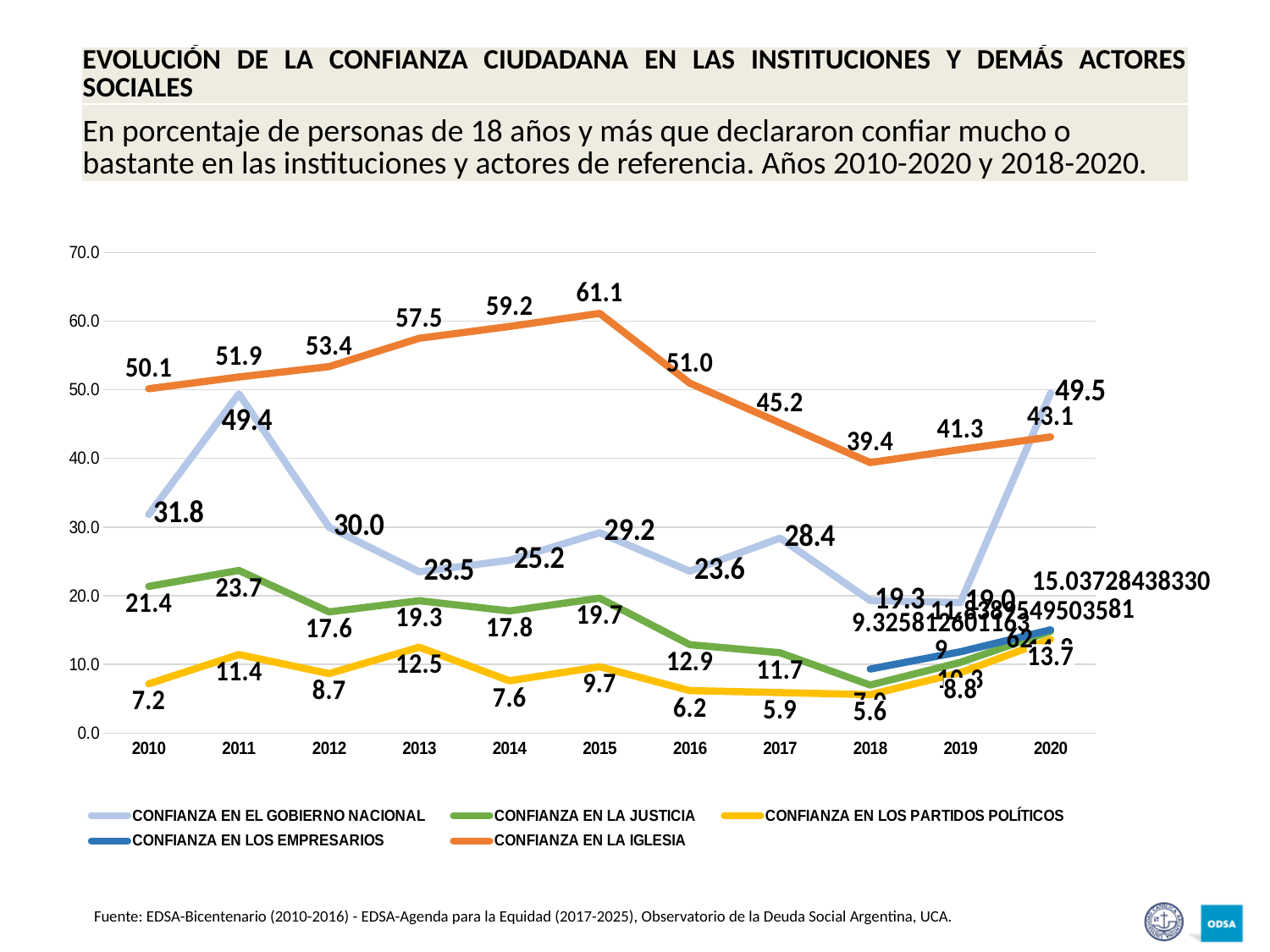
How many series does the legend list? 5 In which year does CONFIANZA EN LA IGLESIA reach its lowest value? 2018 Is the value for CONFIANZA EN LA JUSTICIA in 2016 greater or less than 20.0? less What is the value for CONFIANZA EN EL GOBIERNO NACIONAL in 2011? 49.4 In which year does CONFIANZA EN LA IGLESIA reach its highest value? 2015 What is the value for CONFIANZA EN LA IGLESIA in 2015? 61.1 Which series has the highest value in 2015? CONFIANZA EN LA IGLESIA Does CONFIANZA EN LA IGLESIA rise or fall from 2010 to 2015? rise What is the value for CONFIANZA EN LOS PARTIDOS POLÍTICOS in 2013? 12.5 What type of chart is shown on the slide? line chart How many years are plotted along the x axis? 11 What is the difference between the CONFIANZA EN LA IGLESIA values in 2015 and 2018? 21.7